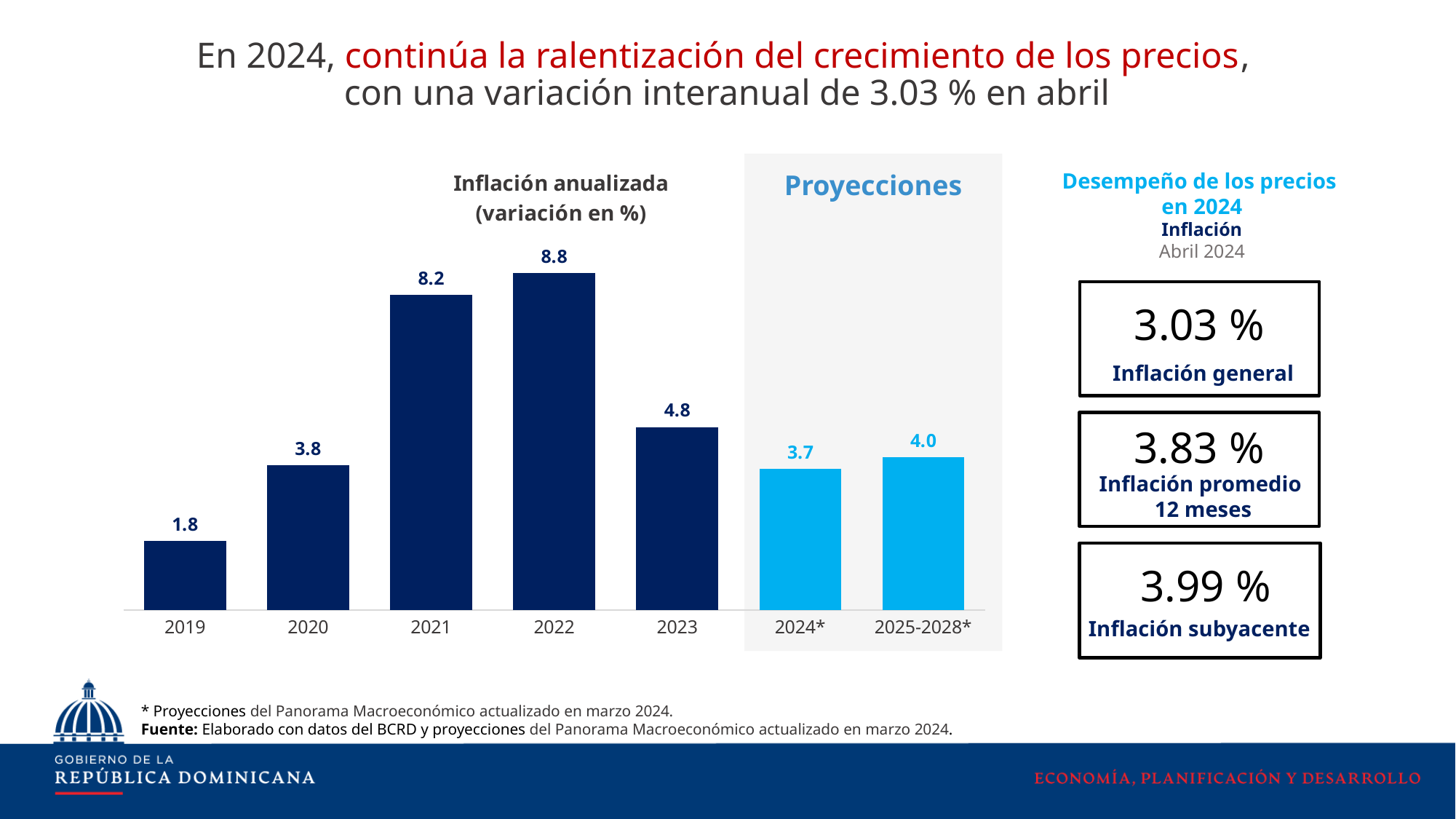
What is the annualized inflation value shown for 2022? 8.8 How many bars are plotted in the chart? 7 What is the difference between the inflation values for 2022 and 2023? 4.0 What type of chart is shown on the slide? Bar chart What is the projected inflation value for 2024*? 3.7 What is the annualized inflation value shown for 2019? 1.8 What is the title of the chart? Inflación anualizada (variación en %) Which year has the highest annualized inflation in the chart? 2022 What is the projected inflation value for 2025-2028*? 4.0 Which category has the lowest value in the chart? 2019 What is the difference between the inflation values for 2021 and 2020? 4.4 Which is larger, the value for 2023 or the projected value for 2024*? 2023